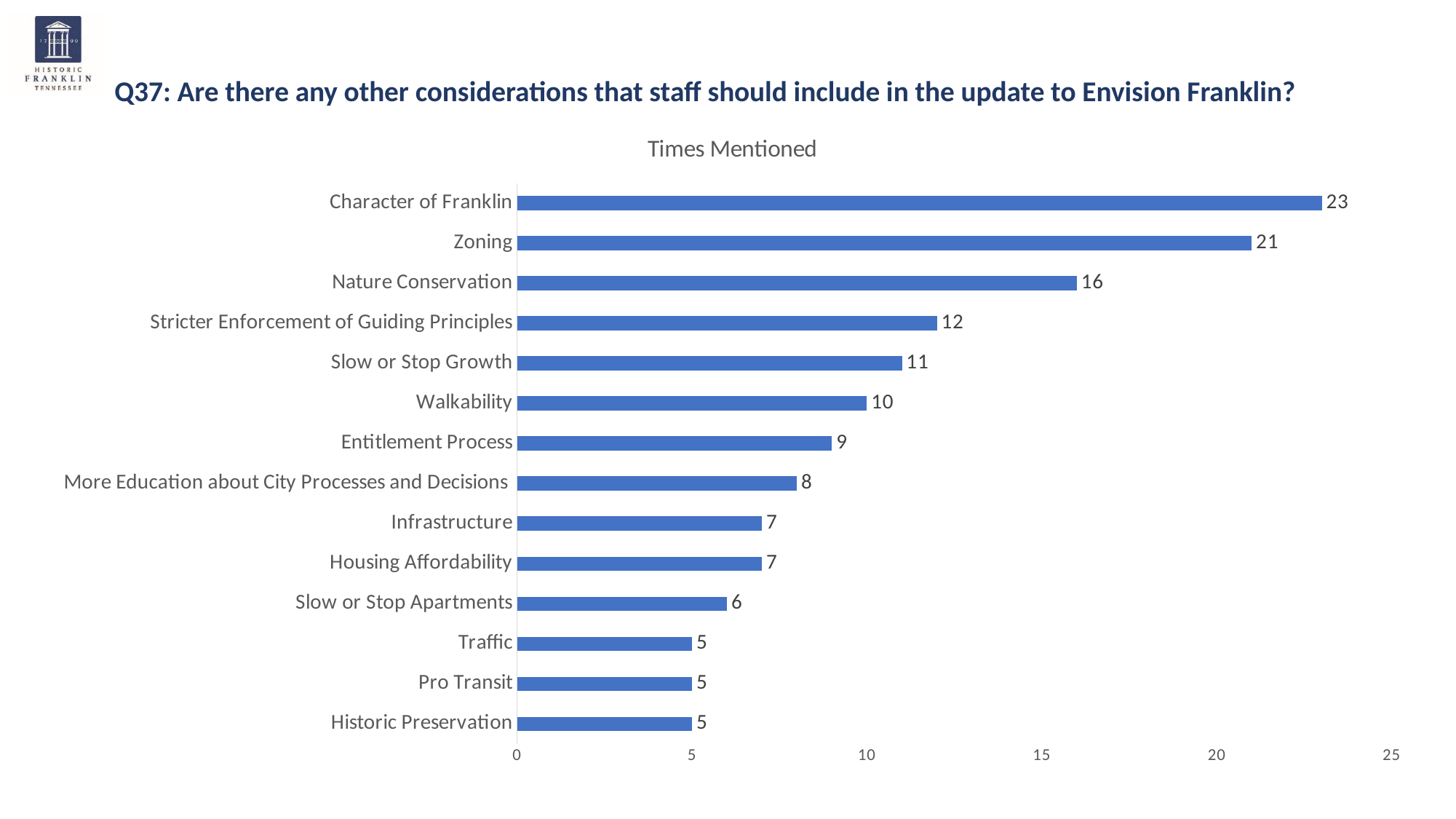
Is the value for Stricter Enforcement of Guiding Principles greater or less than 10? greater Which is larger, the value for Slow or Stop Growth or the value for Entitlement Process? Slow or Stop Growth How many times was Walkability mentioned? 10 How many categories are shown in the chart? 14 What is the value for Nature Conservation? 16 What is the value for Slow or Stop Apartments? 6 Which category has the highest number of times mentioned? Character of Franklin What is the difference between the values for Character of Franklin and Historic Preservation? 18 How many times was Character of Franklin mentioned? 23 What is the title of the chart? Times Mentioned What is the difference between the values for Zoning and Nature Conservation? 5 What kind of chart is shown on the slide? bar chart